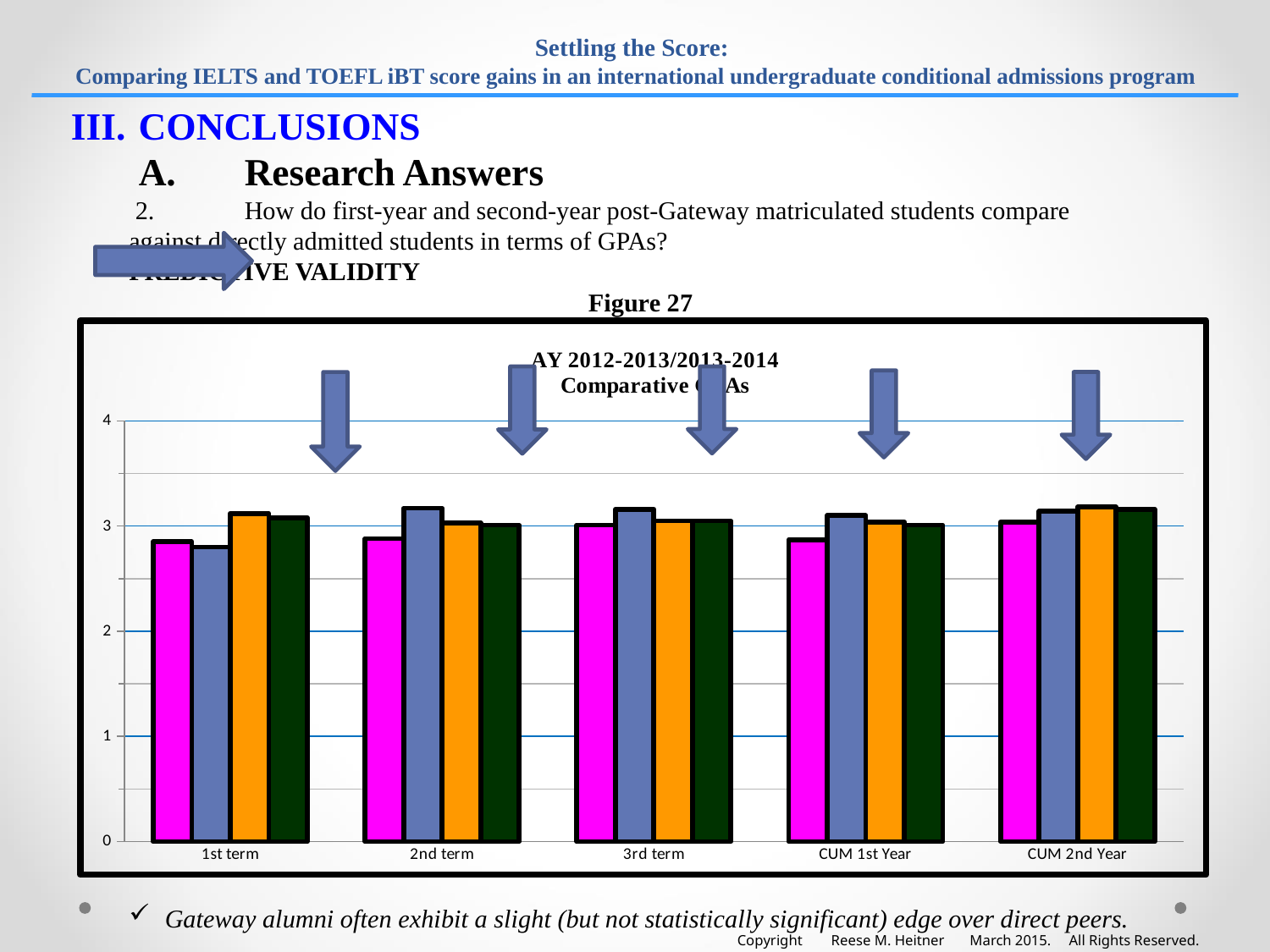
Is the value of the blue bar for 2nd term greater or less than 3? greater Are all the bars on the chart below the value 4 on the y axis? yes Is the value of the orange bar for 1st term greater or less than 3? greater What kind of chart is shown in Figure 27? bar chart How many categories are shown along the x axis of the chart? 5 Which is larger: the magenta bar for 1st term or the blue bar for 2nd term? the blue bar for 2nd term What figure number is given to the chart on the slide? Figure 27 What is the title printed above the chart's plot area? AY 2012-2013/2013-2014 Comparative GPAs How many bars are plotted for each category on the chart? 4 Which coloured bar is the highest in the 2nd term category? blue